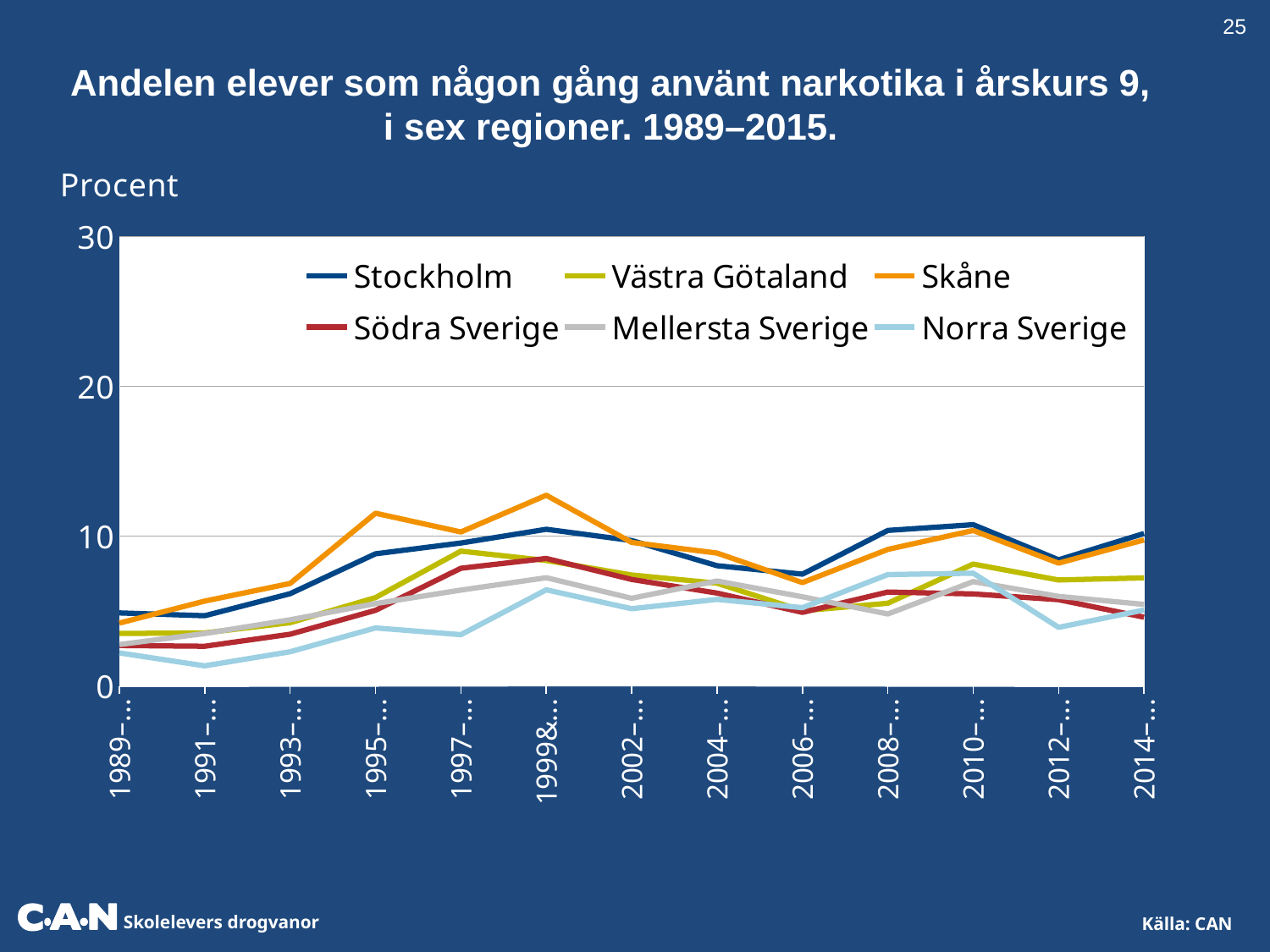
How many series does the legend list? 6 What is the highest value shown on the y axis? 30 Which region has the highest value at 1999? Skåne Is the value for Norra Sverige at 1991 greater or less than 10? less What kind of chart is shown on the slide? line chart Is the value for Skåne at 1995 greater or less than 10? greater Is the value for Skåne at 1999 greater or less than 10? greater Does the Stockholm line rise or fall from 1989 to 1999? rise At 1991, which is larger: the value for Stockholm or the value for Norra Sverige? Stockholm Which region has the lowest value at 1991? Norra Sverige At 1995, which is larger: the value for Skåne or the value for Norra Sverige? Skåne What unit label is shown above the y axis? Procent